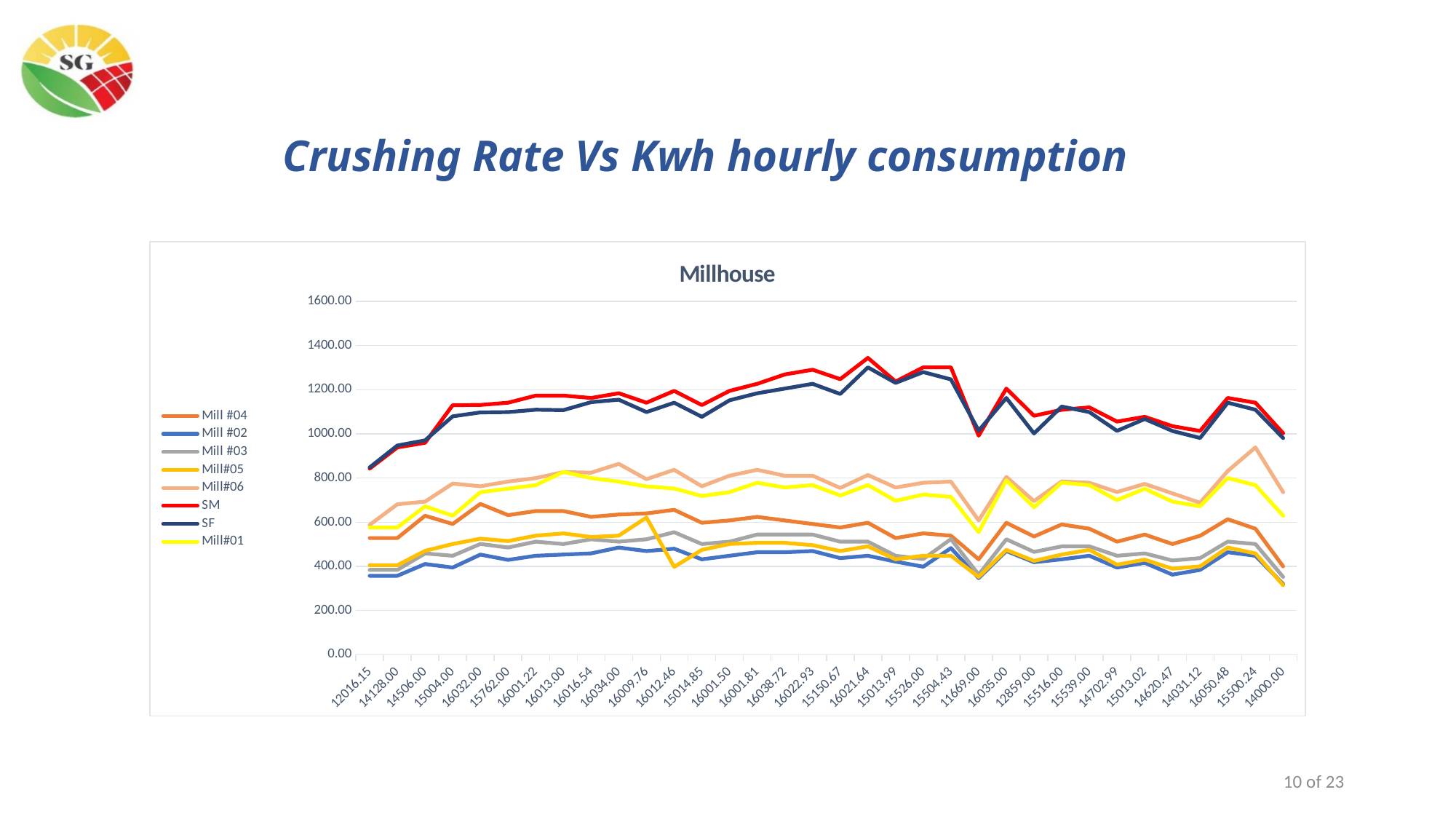
Is the Mill #02 value at 11669.00 greater or less than 400? less At 16021.64, which is larger, the SM value or the Mill#06 value? SM What is the title of the chart? Millhouse What kind of chart is shown on the slide? line chart Is the SM value at 16021.64 greater or less than 1200? greater Which series has the highest values across the Millhouse chart? SM How many points are plotted along the x axis of the Millhouse chart? 34 Do the SM values rise or fall from 12016.15 to 16032.00? rise Is the Mill#06 value at 15500.24 greater or less than 800? greater Which series is drawn in red in the Millhouse chart? SM How many series does the legend of the Millhouse chart list? 8